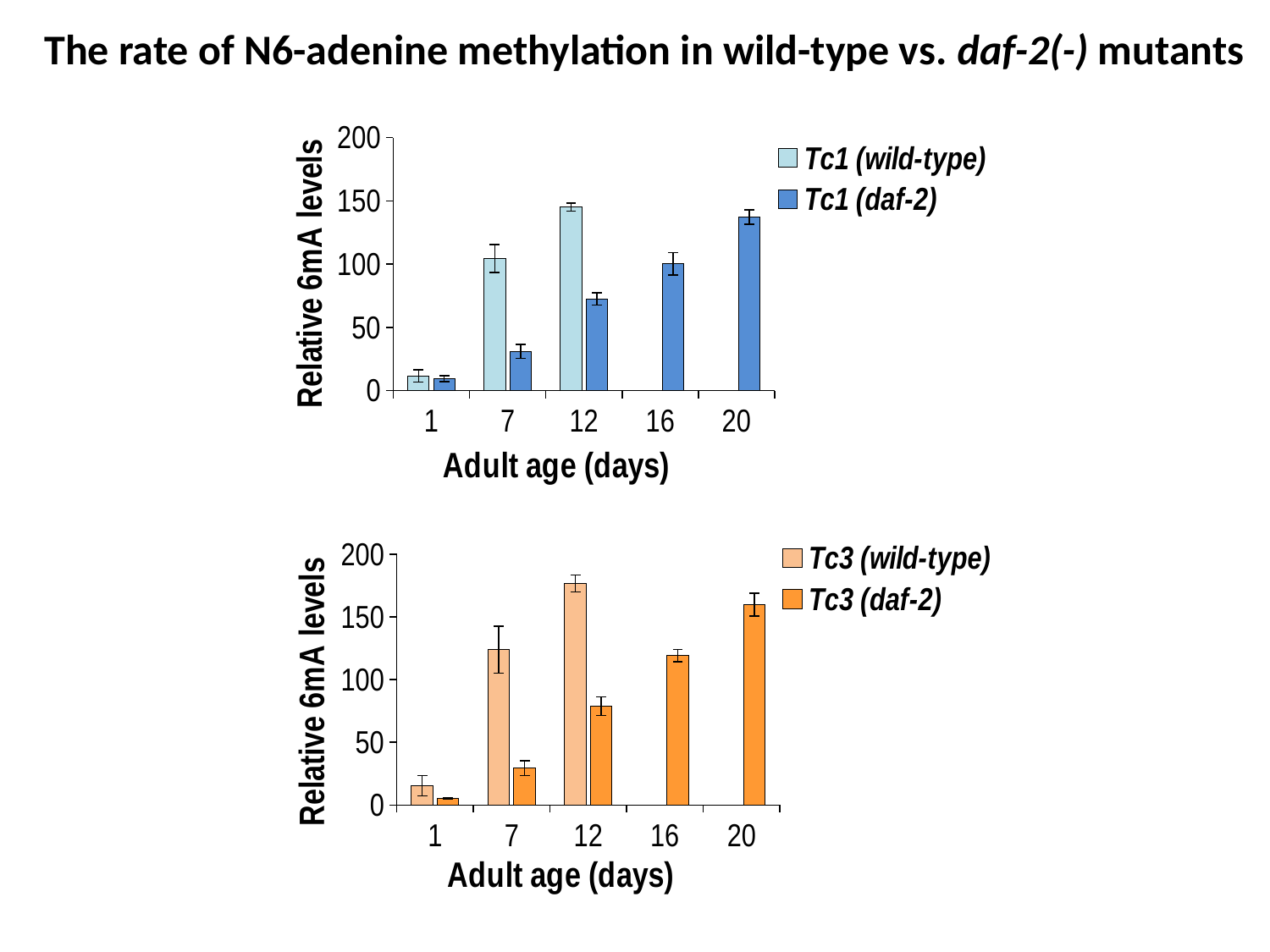
In the bottom chart (Tc3), is the value for Tc3 (wild-type) at adult age 12 days greater or less than 150? greater In the bottom chart (Tc3), is the value for Tc3 (daf-2) at adult age 16 days greater or less than 100? greater In the top chart (Tc1), is the value for Tc1 (wild-type) at adult age 12 days greater or less than 100? greater In the bottom chart (Tc3), what is the label on the y axis? Relative 6mA levels In the top chart (Tc1), at which adult age is the Tc1 (daf-2) value highest? 20 In the top chart (Tc1), what kind of chart is shown? bar chart In the top chart (Tc1), how many series does the legend list? 2 In the bottom chart (Tc3), do the Tc3 (daf-2) values rise or fall as adult age increases from 1 to 20 days? rise In the top chart (Tc1), how many adult age categories are shown on the x axis? 5 In the top chart (Tc1), at adult age 12 days, which series has the larger value, Tc1 (wild-type) or Tc1 (daf-2)? Tc1 (wild-type) In the bottom chart (Tc3), at which adult age is the Tc3 (daf-2) value lowest? 1